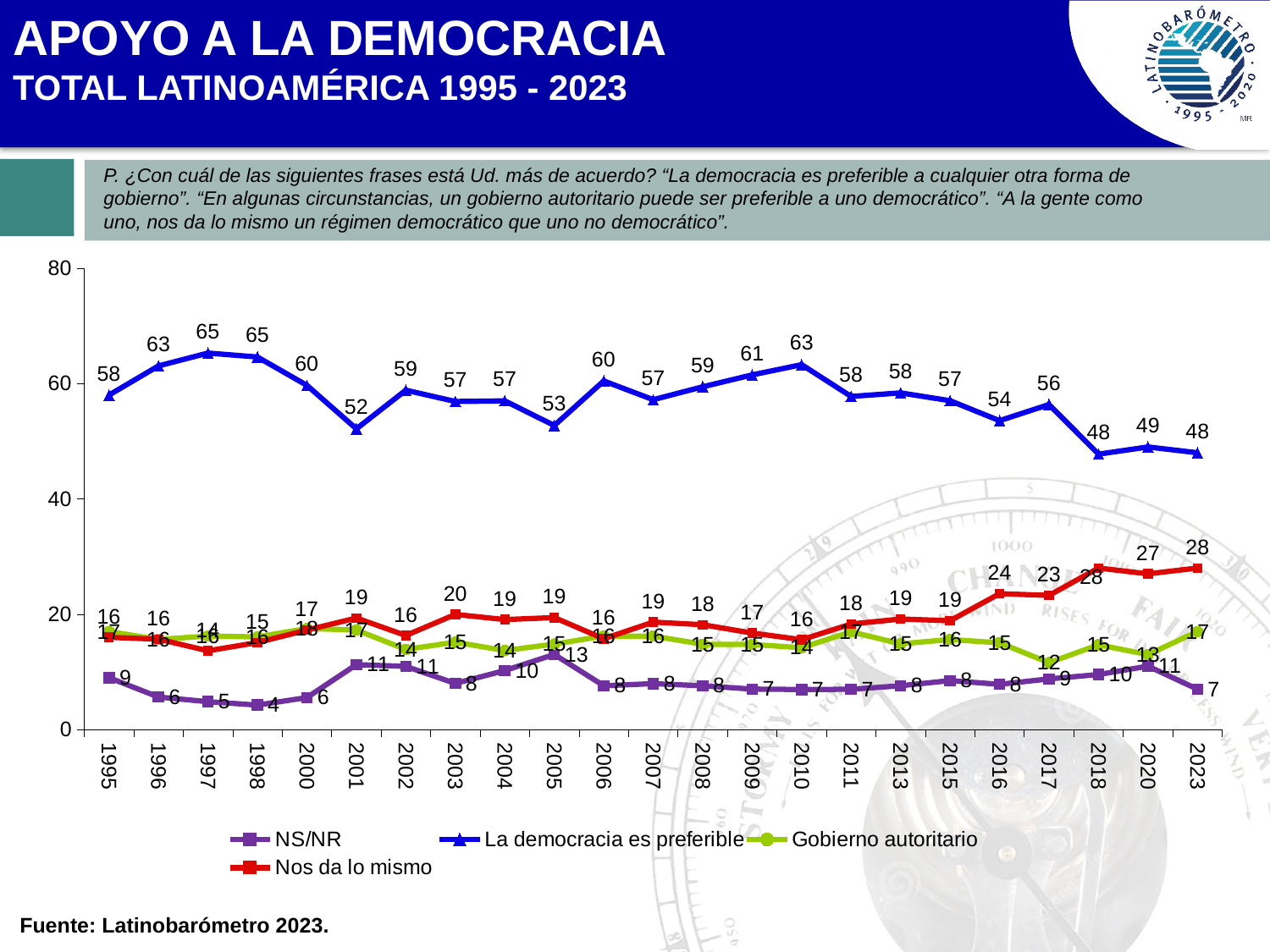
What is the value for 'NS/NR' in 2023? 7 What is the value for 'La democracia es preferible' in 2010? 63 Does 'La democracia es preferible' rise or fall from 2010 to 2023? fall What is the value for 'Nos da lo mismo' in 2023? 28 What kind of chart is shown on the slide? line chart How many series does the legend list? 4 What is the value for 'Nos da lo mismo' in 2016? 24 What is the value for 'La democracia es preferible' in 2023? 48 In 2023, which is larger: 'Gobierno autoritario' or 'NS/NR'? Gobierno autoritario How many years are plotted along the x axis? 23 Which series has the highest values across all years? La democracia es preferible What is the difference between 'La democracia es preferible' and 'Nos da lo mismo' in 2023? 20